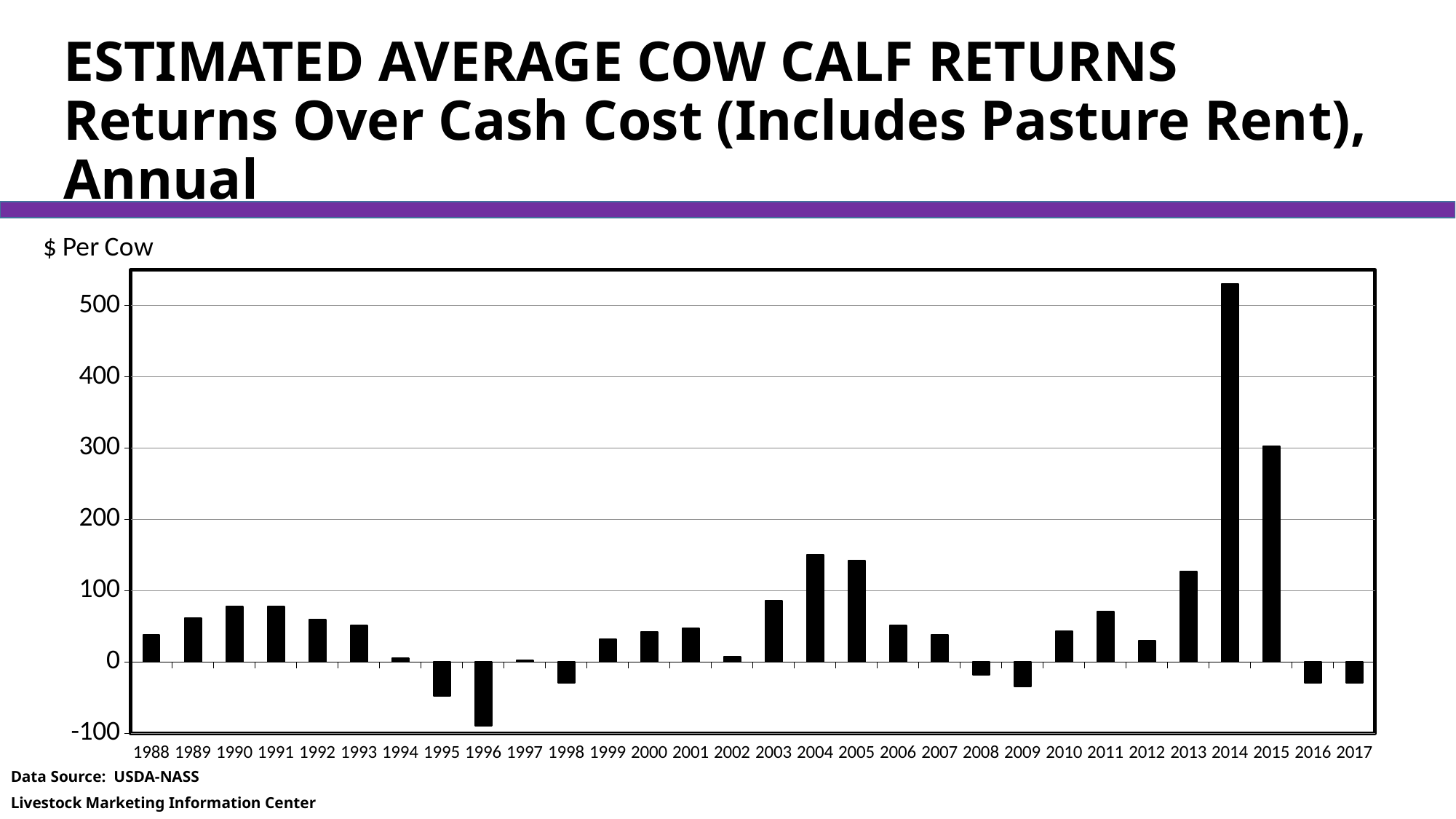
Is the value for 2004 greater or less than 100? greater Is the value for 2016 greater or less than 0? less Which year has the highest returns over cash cost? 2014 Do the values rise or fall from 2014 to 2017? fall What kind of chart is shown on the slide? bar chart Which year has the lowest returns over cash cost? 1996 Is the value for 2014 greater or less than 500? greater How many years are plotted on the x axis? 30 Which year has the larger value, 2014 or 2015? 2014 Which year has the larger value, 2003 or 2006? 2003